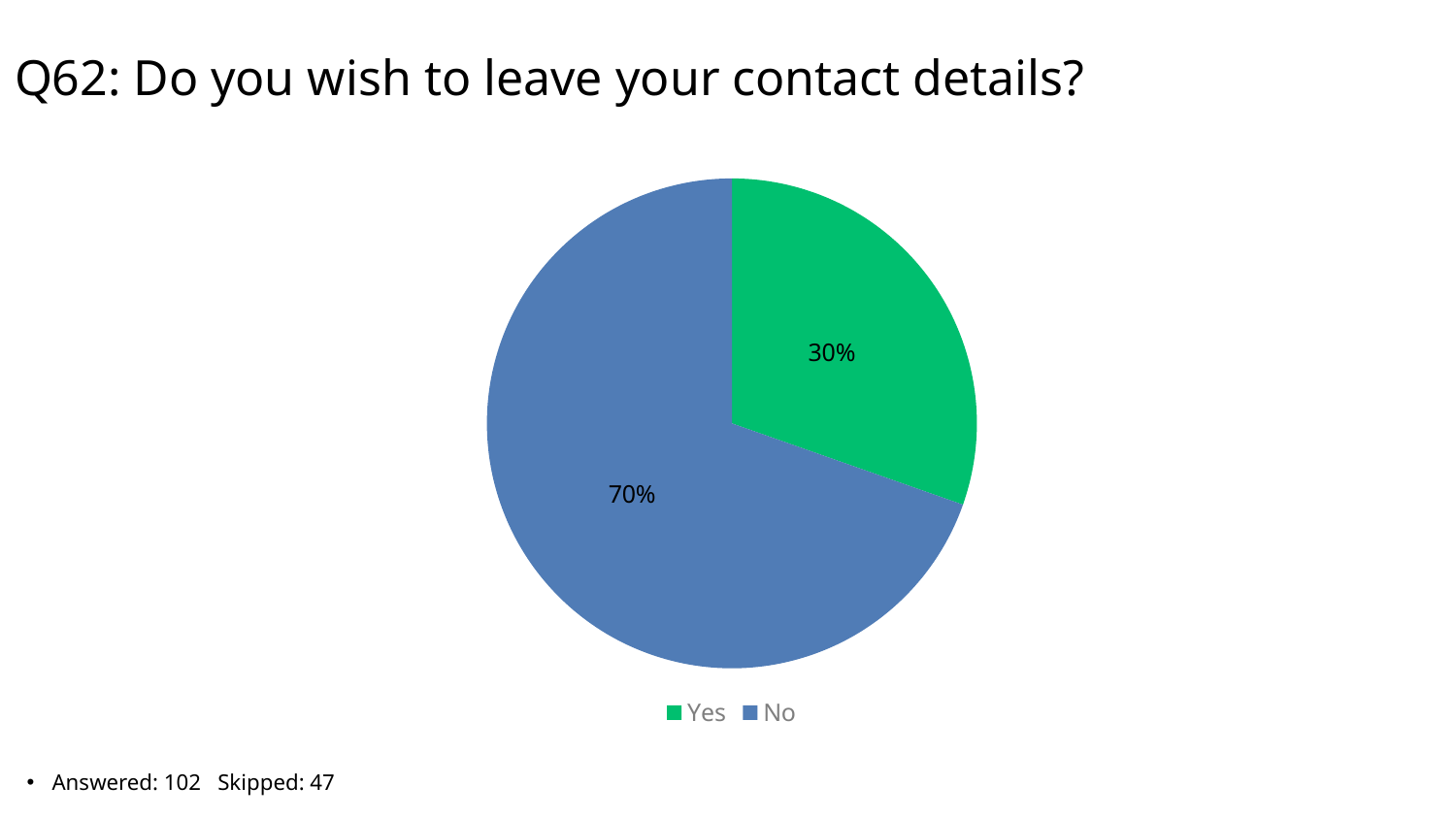
How many entries does the legend list? 2 What is the title of the slide containing the pie chart? Q62: Do you wish to leave your contact details? Which slice of the pie is the largest? No What share of the pie is labelled "Yes"? 30% Which is larger, the "Yes" slice or the "No" slice? No What is the difference in percentage points between the "No" slice and the "Yes" slice? 40 percentage points Which slice of the pie is the smallest? Yes What kind of chart is shown on the slide? pie chart What share of the pie is labelled "No"? 70% What colour is the "Yes" slice? green How many slices does the pie chart have? 2